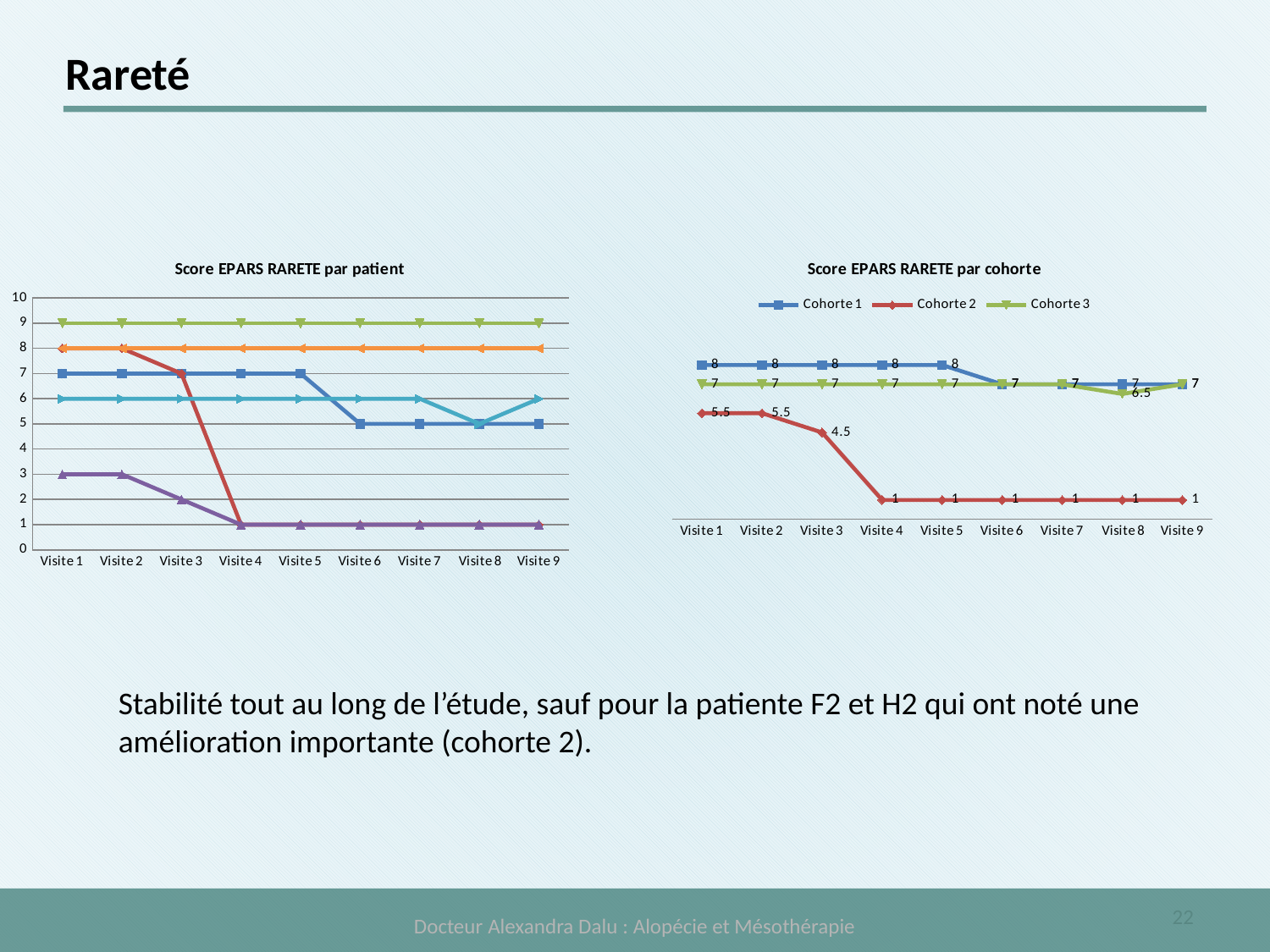
In the chart titled 'Score EPARS RARETE par cohorte', what is the value for Cohorte 1 at Visite 1? 8 In the chart titled 'Score EPARS RARETE par cohorte', which cohort has the lowest value at Visite 4? Cohorte 2 In the chart titled 'Score EPARS RARETE par cohorte', what is the value for Cohorte 3 at Visite 8? 6.5 In the chart titled 'Score EPARS RARETE par cohorte', which cohort has the highest value at Visite 2? Cohorte 1 In the chart titled 'Score EPARS RARETE par cohorte', what is the difference between Cohorte 1 and Cohorte 2 at Visite 1? 2.5 In the chart titled 'Score EPARS RARETE par cohorte', how many series does the legend list? 3 In the chart titled 'Score EPARS RARETE par cohorte', what is the value for Cohorte 2 at Visite 9? 1 In the chart titled 'Score EPARS RARETE par cohorte', does the value for Cohorte 2 rise or fall from Visite 1 to Visite 9? fall In the chart titled 'Score EPARS RARETE par patient', how many visits are shown on the x axis? 9 In the chart titled 'Score EPARS RARETE par cohorte', what is the value for Cohorte 2 at Visite 3? 4.5 In the chart titled 'Score EPARS RARETE par cohorte', is the value for Cohorte 1 or Cohorte 3 larger at Visite 5? Cohorte 1 What kind of chart is the chart titled 'Score EPARS RARETE par patient'? line chart